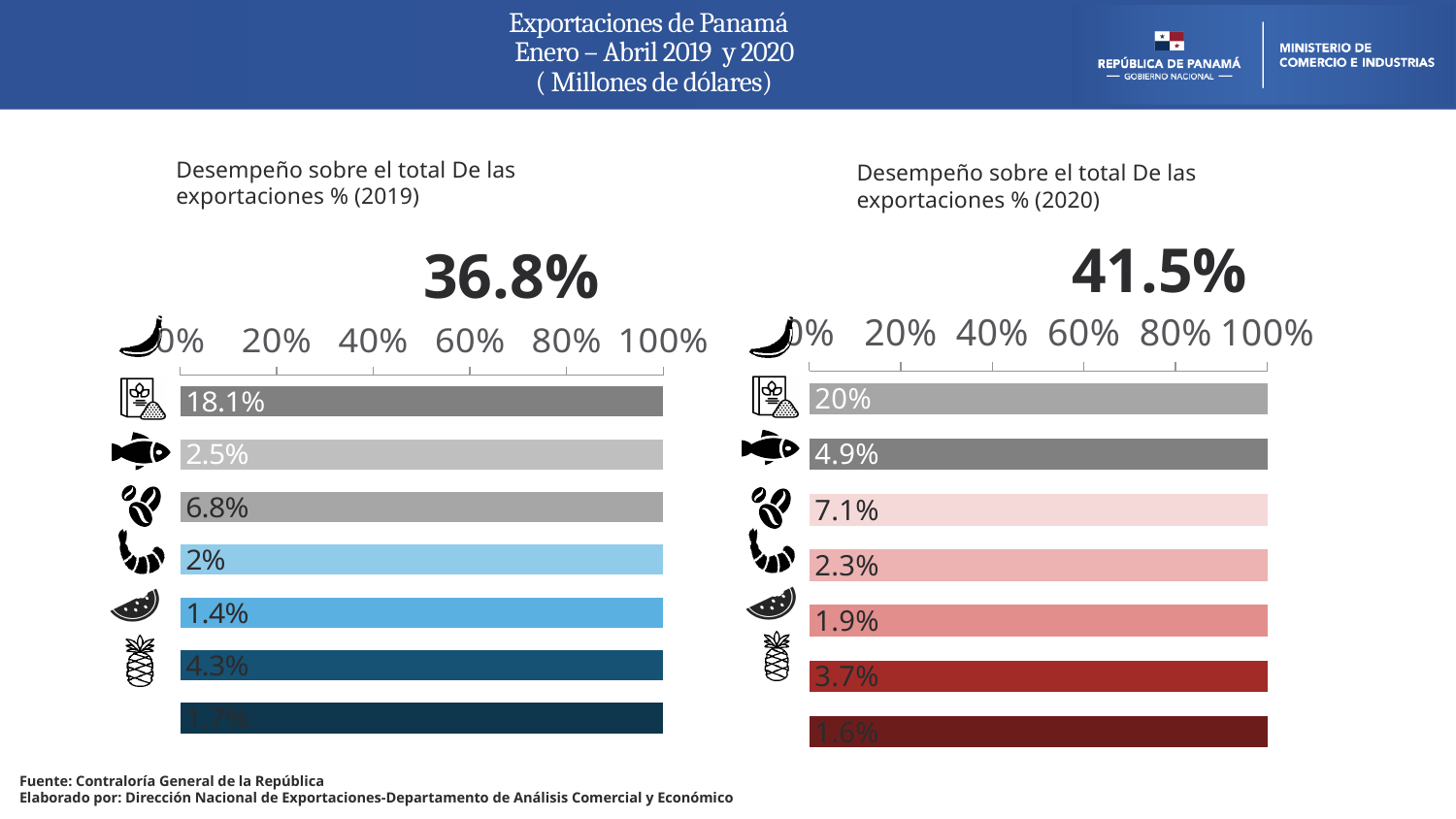
In the left chart (2019), what value is shown on the bar with the fish icon? 2.5% In the right chart (2020), what value is shown on the bar with the coffee beans icon? 7.1% In the left chart (2019), what is the value shown on the first bar, next to the sugar/salt icon? 18.1% In the right chart (2020), which bar has the highest labelled value? The first bar (sugar/salt icon), 20% In the right chart (2020), what is the value shown on the first bar, next to the sugar/salt icon? 20% In the left chart (2019), what value is shown on the bar with the watermelon icon? 1.4% By how many percentage points does the first bar's value in the 2020 chart exceed the first bar's value in the 2019 chart? 1.9 percentage points In the left chart (2019), what is the difference between the coffee beans bar (6.8%) and the fish bar (2.5%)? 4.3 percentage points Is the coffee beans bar value larger in the 2019 chart or the 2020 chart? 2020 chart What type of chart is used on this slide? Bar chart What large percentage figure is displayed above the right chart (2020)? 41.5% What large percentage figure is displayed above the left chart (2019)? 36.8%